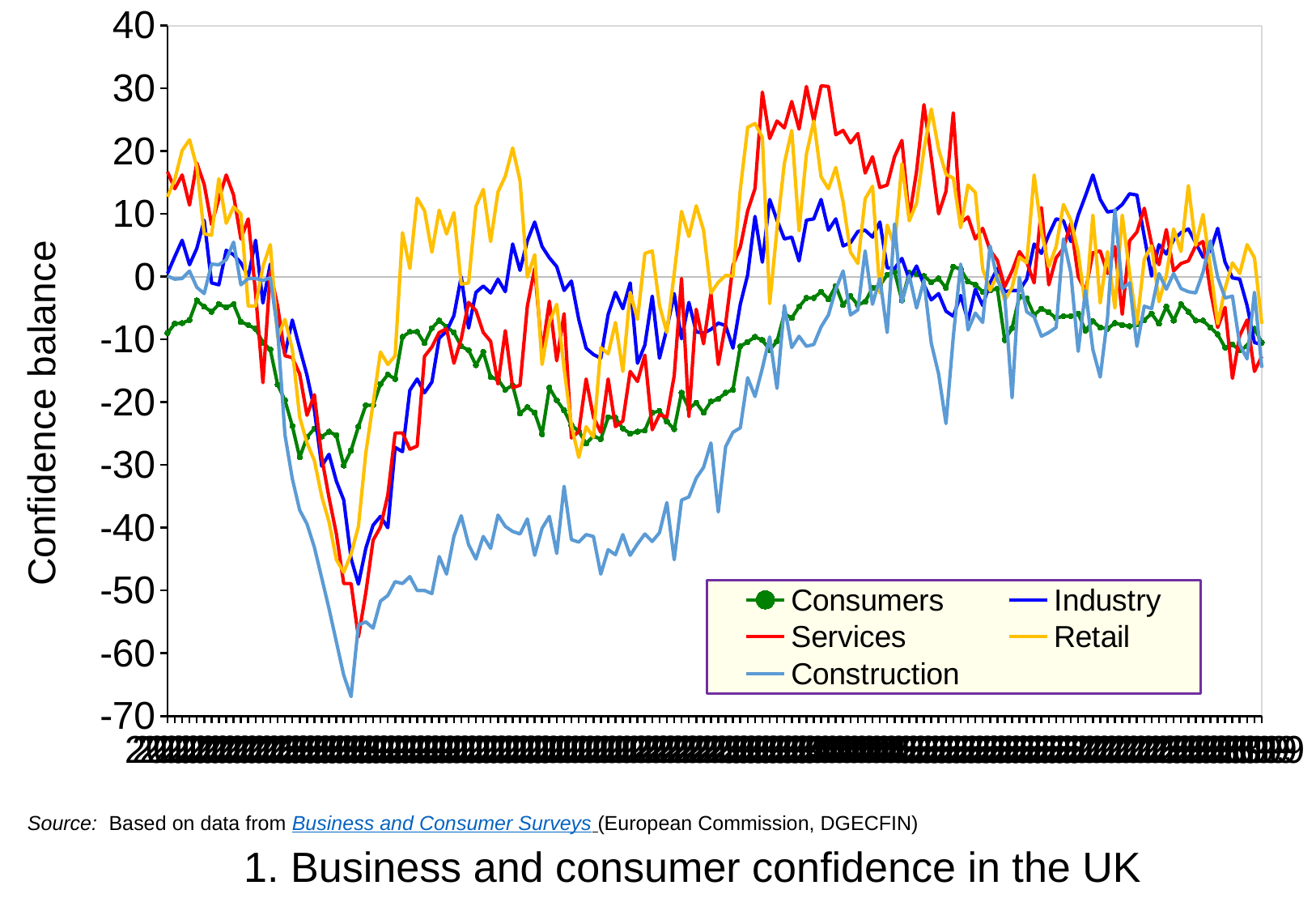
What kind of chart is shown on the slide? Line chart Is the highest value of the Consumers series greater or less than 10? less Is the lowest value of the Consumers series greater or less than -40? greater At their deepest troughs, which series falls lower, Construction or Consumers? Construction Which series reaches the highest value anywhere on the chart? Services Which series reaches the lowest value anywhere on the chart? Construction Is the lowest value of the Construction series greater or less than -60? less What is the title of the chart? 1. Business and consumer confidence in the UK Which series reaches a higher peak, Services or Consumers? Services How many series does the legend list? 5 What is the label on the vertical axis? Confidence balance